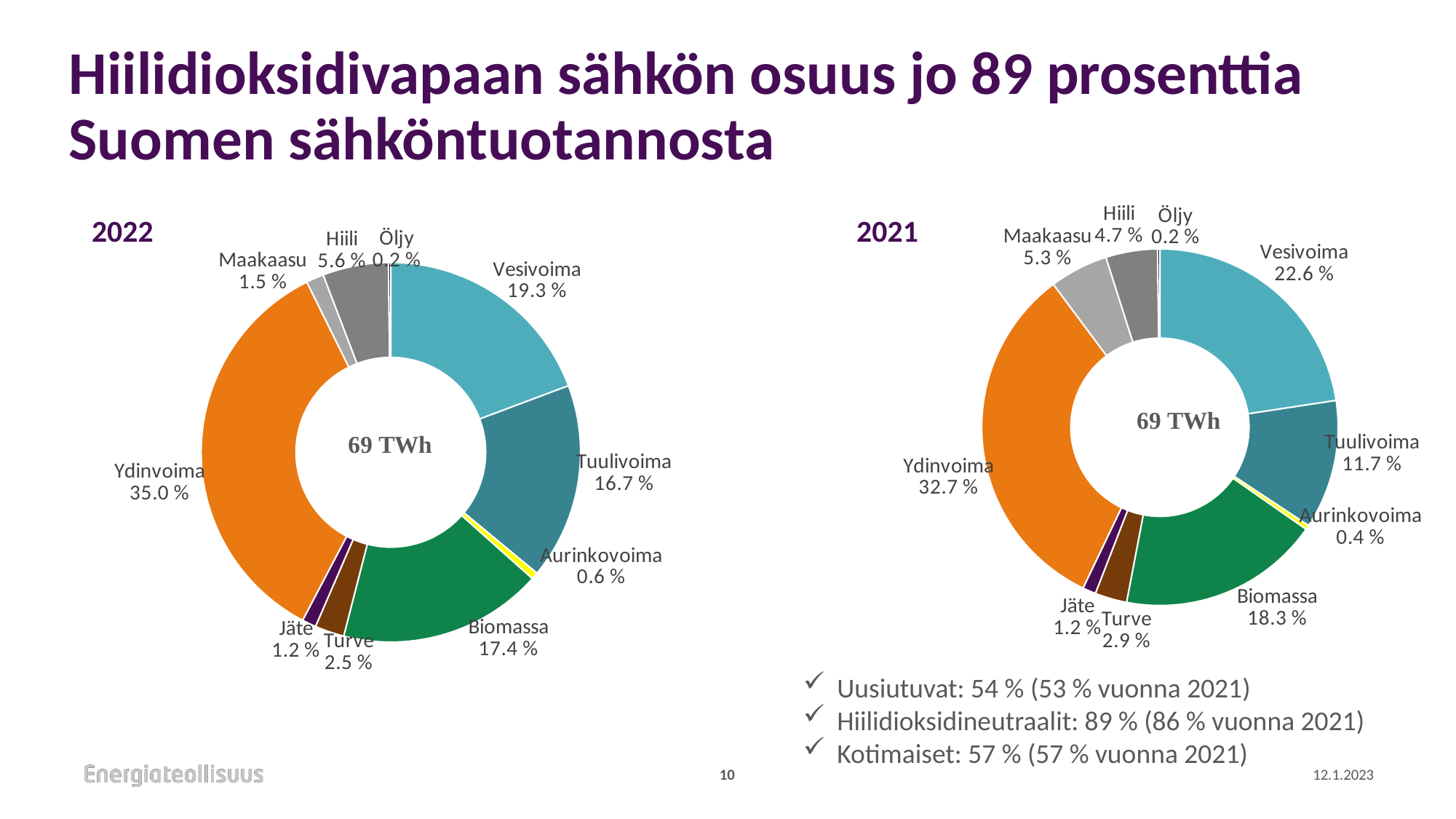
In the 2022 chart, what share does Aurinkovoima have? 0.6 % What kind of chart is the 2021 chart? Donut (pie) chart In the 2021 chart, which is larger, the share of Maakaasu or the share of Hiili? Maakaasu In the 2021 chart, what is the difference between the shares of Ydinvoima and Vesivoima? 10.1 % In the 2022 chart, which category has the largest share? Ydinvoima How many categories are shown in the 2022 chart? 10 In the 2022 chart, what is the difference between the shares of Vesivoima and Tuulivoima? 2.6 % In the 2021 chart, what share does Biomassa have? 18.3 % In the 2021 chart, what share does Tuulivoima have? 11.7 % In the 2021 chart, which category has the smallest share? Öljy What total value is printed in the centre of the 2022 chart? 69 TWh In the 2022 chart, what share does Ydinvoima have? 35.0 %